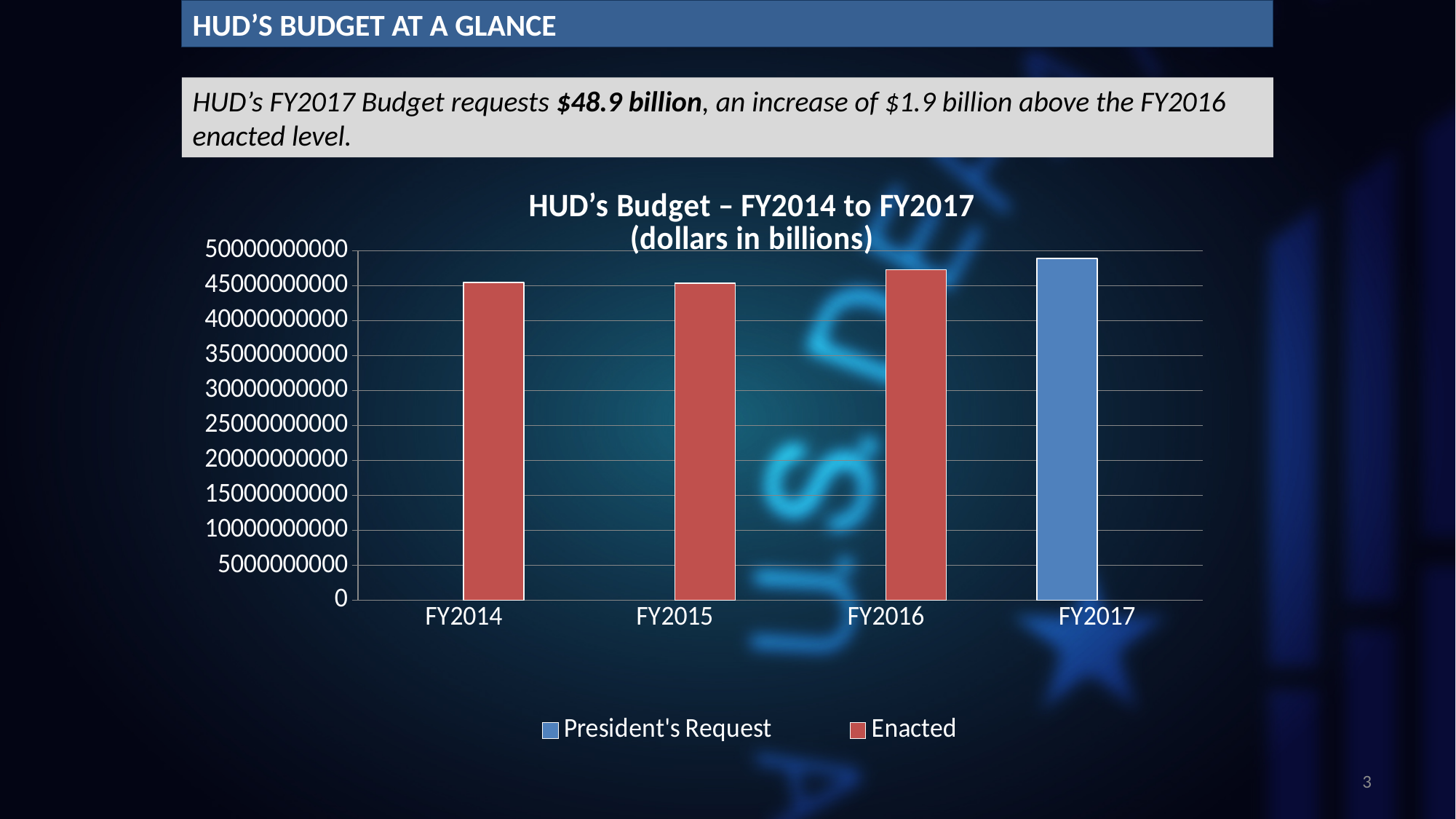
Is the bar for FY2016 greater or less than 45000000000? greater Is the bar for FY2017 greater or less than 50000000000? less Which series is shown in blue in the chart? President's Request According to the slide, what is the FY2017 budget request shown by the blue bar? $48.9 billion What type of chart is shown on the slide? bar chart How many series does the chart legend list? 2 How many fiscal years are shown on the x axis of the chart? 4 Is the bar for FY2015 greater or less than 40000000000? greater Do the bars rise or fall from FY2015 to FY2017? rise Which fiscal year has the highest bar in the chart? FY2017 What is the title of the chart? HUD's Budget – FY2014 to FY2017 (dollars in billions) Which is larger, the bar for FY2016 or the bar for FY2014? FY2016